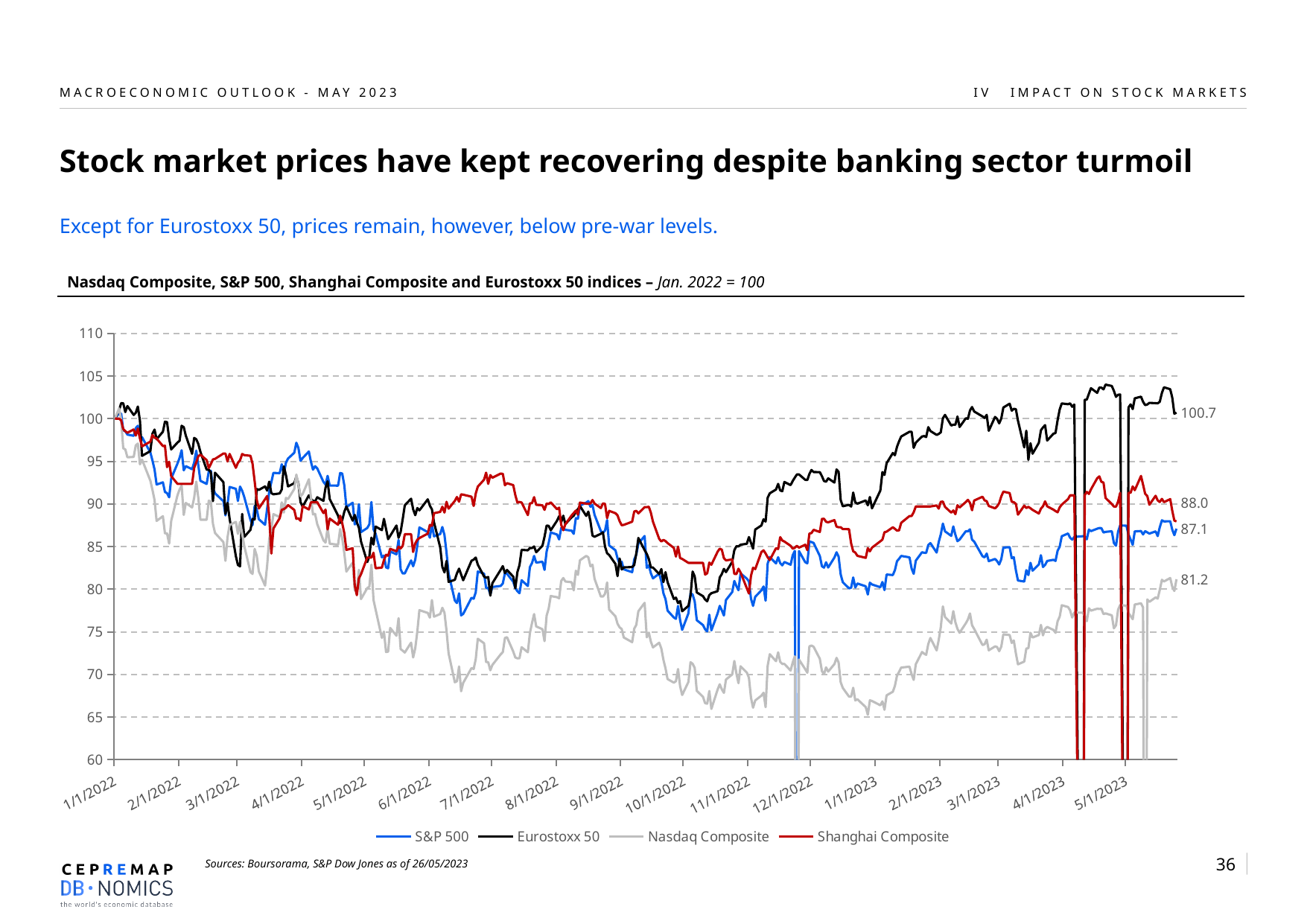
What is the final value shown for the Nasdaq Composite series? 81.2 At the end of the chart, which is higher: the Shanghai Composite or the S&P 500? Shanghai Composite What is the final value shown for the Shanghai Composite series? 88.0 Does the Eurostoxx 50 series rise or fall between 10/1/2022 and 5/1/2023? Rise What kind of chart is shown on the slide? Line chart How many series does the legend list? 4 What is the difference between the final values of Eurostoxx 50 and Nasdaq Composite? 19.5 Which series has the lowest value at the end of the chart? Nasdaq Composite What is the final value shown for the Eurostoxx 50 series? 100.7 What is the final value shown for the S&P 500 series? 87.1 Which series has the highest value at the end of the chart? Eurostoxx 50